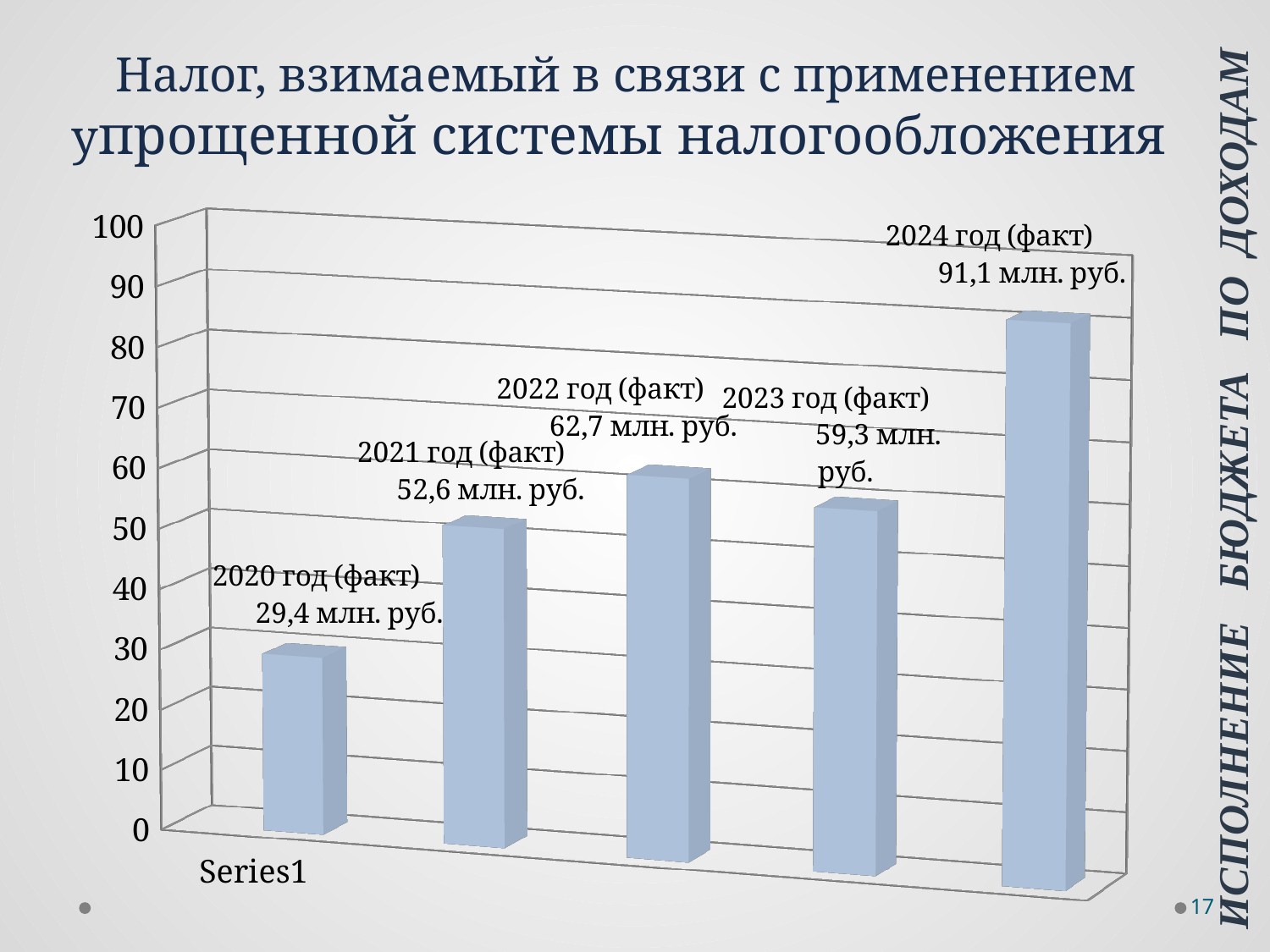
What is the title of the slide? Налог, взимаемый в связи с применением упрощенной системы налогообложения What is the value for 2024 год (факт)? 91,1 млн. руб. What is the difference between the 2022 and 2021 values? 10,1 млн. руб. Which is larger, the value for 2022 or the value for 2023? 2022 Which year has the highest value? 2024 год (факт) What is the value for 2020 год (факт)? 29,4 млн. руб. What kind of chart is shown on the slide? Bar chart How many bars are shown in the chart? 5 What is the value for 2021 год (факт)? 52,6 млн. руб. Which year has the lowest value? 2020 год (факт) What is the value for 2023 год (факт)? 59,3 млн. руб. What is the difference between the 2024 and 2023 values? 31,8 млн. руб.